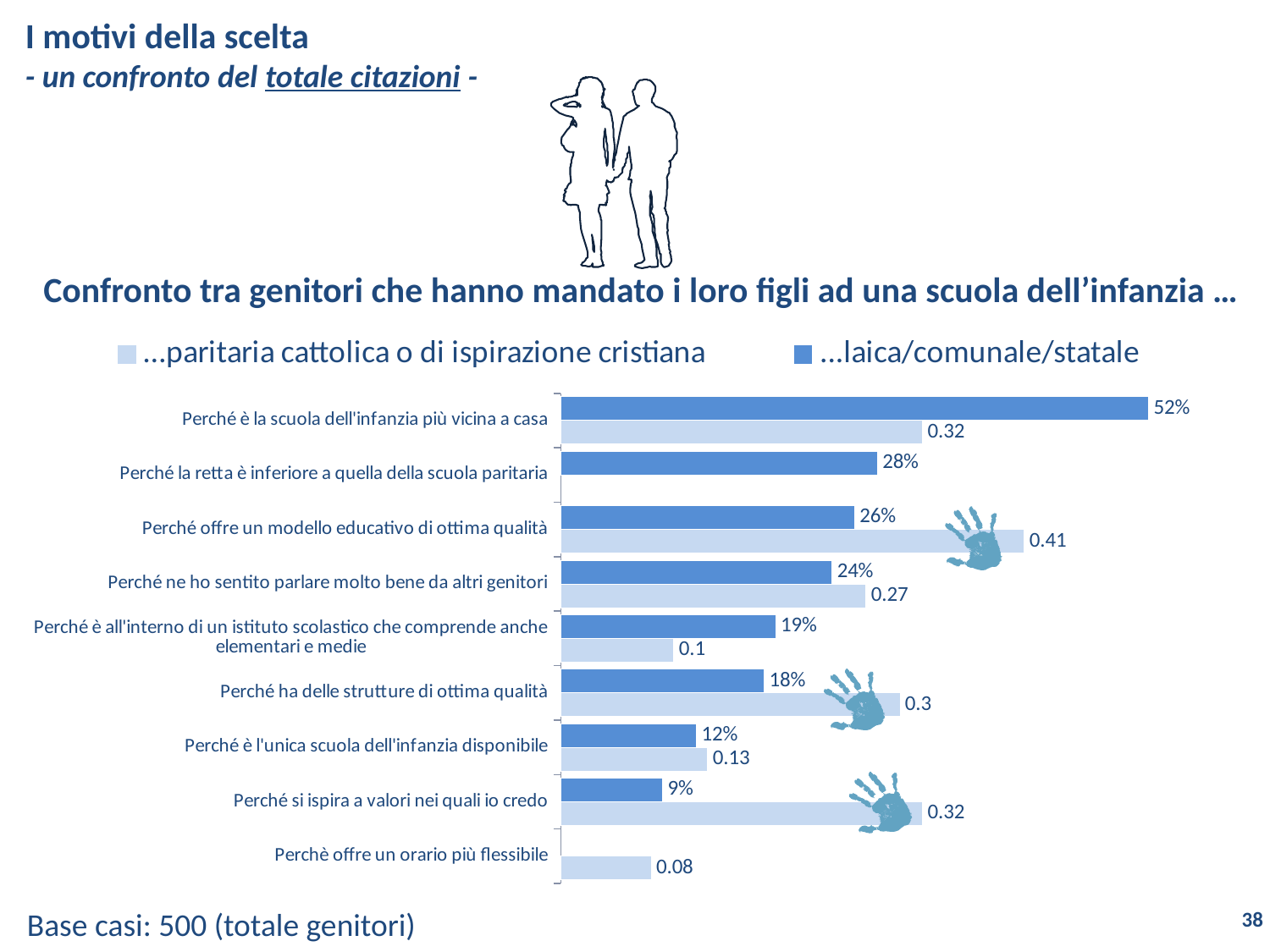
Which reason has the lowest value in the paritaria cattolica o di ispirazione cristiana series? Perchè offre un orario più flessibile How many reasons (categories) are listed on the chart? 9 For "Perché ha delle strutture di ottima qualità", which series has the larger value: laica/comunale/statale (18%) or paritaria cattolica (0.3)? paritaria cattolica o di ispirazione cristiana Which reason has the highest value in the paritaria cattolica o di ispirazione cristiana series? Perché offre un modello educativo di ottima qualità Which reason has the highest value in the laica/comunale/statale series? Perché è la scuola dell'infanzia più vicina a casa How many series does the legend list? 2 What percentage of parents who chose a laica/comunale/statale school cited "Perché è la scuola dell'infanzia più vicina a casa"? 52% What value is shown for the paritaria cattolica o di ispirazione cristiana series for "Perché offre un modello educativo di ottima qualità"? 0.41 What is the difference in percentage points between "Perché è la scuola dell'infanzia più vicina a casa" and "Perché la retta è inferiore a quella della scuola paritaria" in the laica/comunale/statale series? 24 percentage points What value is shown for the paritaria cattolica o di ispirazione cristiana series for "Perché si ispira a valori nei quali io credo"? 0.32 What percentage is shown for the laica/comunale/statale series for "Perché è l'unica scuola dell'infanzia disponibile"? 12% What type of chart is shown on the slide? Bar chart